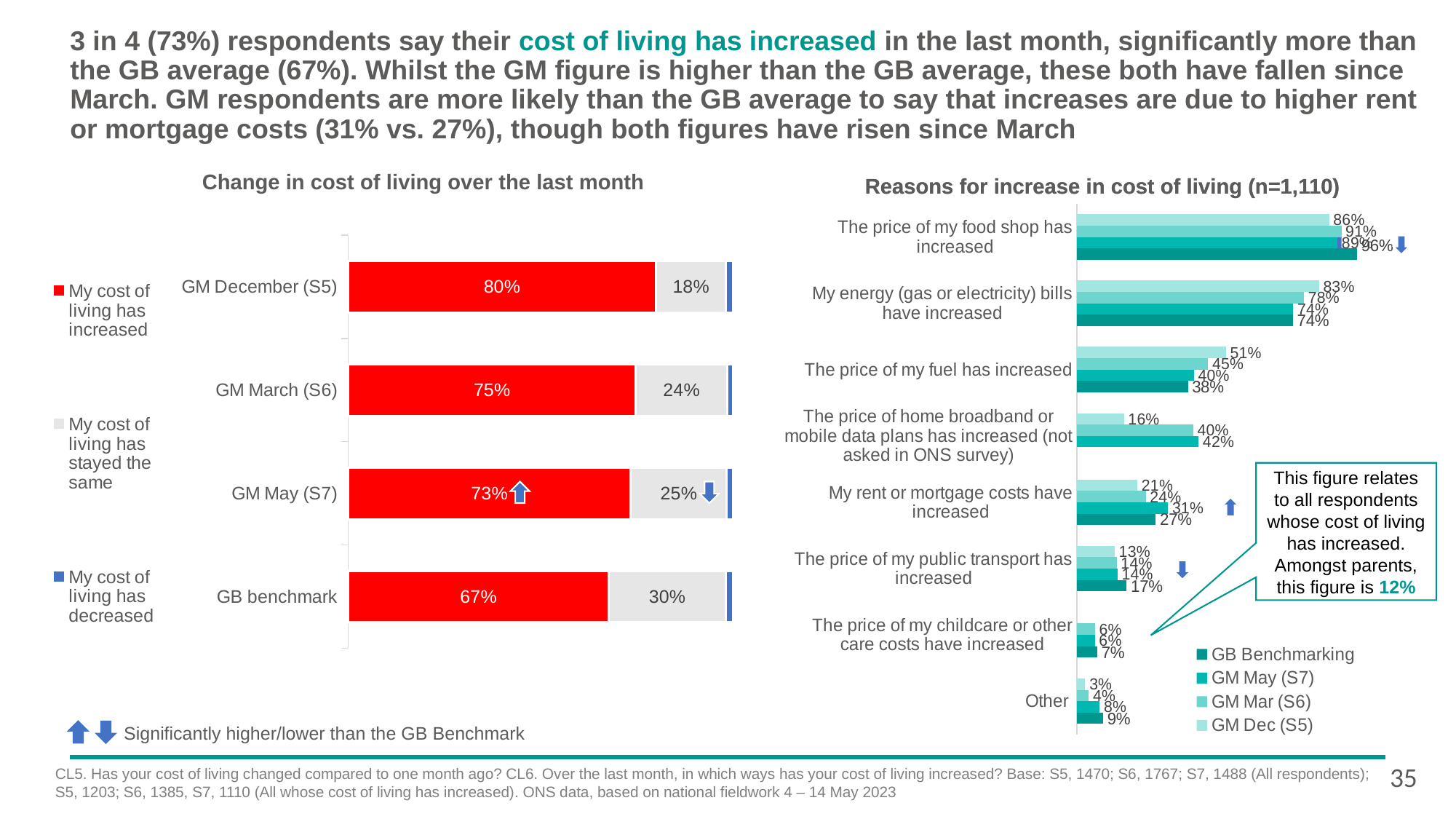
In the 'Reasons for increase in cost of living' chart, how many series does the legend list? 4 In the 'Reasons for increase in cost of living' chart, what is the GM May (S7) value for 'My rent or mortgage costs have increased'? 31% In the 'Reasons for increase in cost of living' chart, how many reason categories are shown? 8 In the 'Change in cost of living over the last month' chart, what percentage of GM December (S5) respondents said their cost of living has increased? 80% In the 'Reasons for increase in cost of living' chart, what is the GB Benchmarking value for 'The price of my food shop has increased'? 96% In the 'Change in cost of living over the last month' chart, how many series does the legend list? 3 In the 'Change in cost of living over the last month' chart, which category has the lowest share saying their cost of living has increased? GB benchmark What kind of chart is 'Reasons for increase in cost of living (n=1,110)'? Bar chart In the 'Reasons for increase in cost of living' chart, which reason has the highest values across all series? The price of my food shop has increased In the 'Change in cost of living over the last month' chart, what is the difference between the GM May (S7) and GB benchmark shares saying their cost of living has increased? 6 percentage points In the 'Change in cost of living over the last month' chart, what percentage of GB benchmark respondents said their cost of living has stayed the same? 30% In the 'Change in cost of living over the last month' chart, which is larger: the 'stayed the same' share for GM March (S6) or for GM December (S5)? GM March (S6)